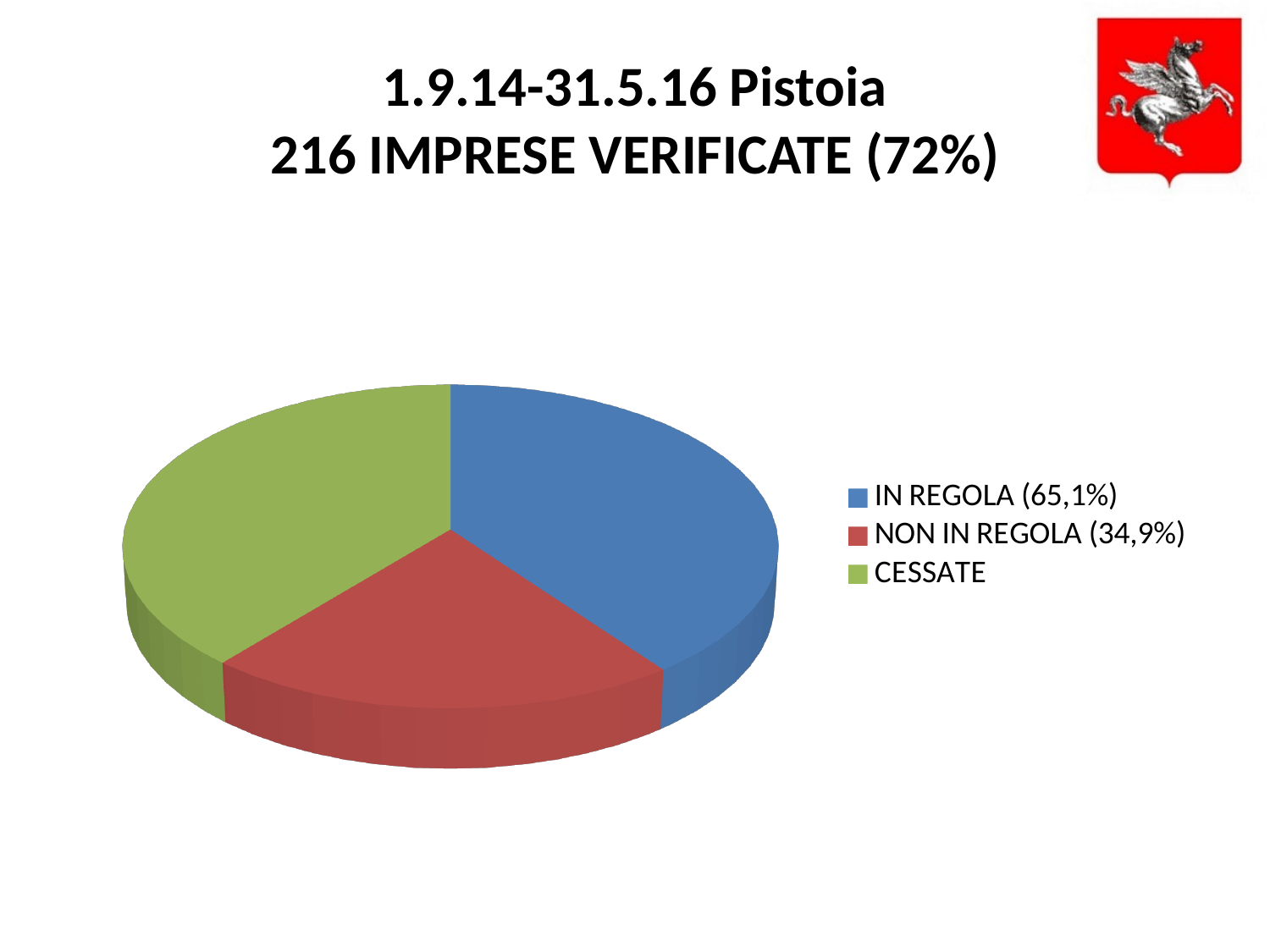
How many entries does the legend of the pie chart list? 3 Which slice of the pie chart is the smallest? NON IN REGOLA Which slice is larger, IN REGOLA or NON IN REGOLA? IN REGOLA What percentage is printed next to NON IN REGOLA in the legend? 34,9% What is the title shown above the pie chart? 1.9.14-31.5.16 Pistoia 216 IMPRESE VERIFICATE (72%) What kind of chart is shown on the slide? pie chart What percentage is printed next to IN REGOLA in the legend? 65,1% How many slices does the pie chart have? 3 What colour is the CESSATE slice in the pie chart? green